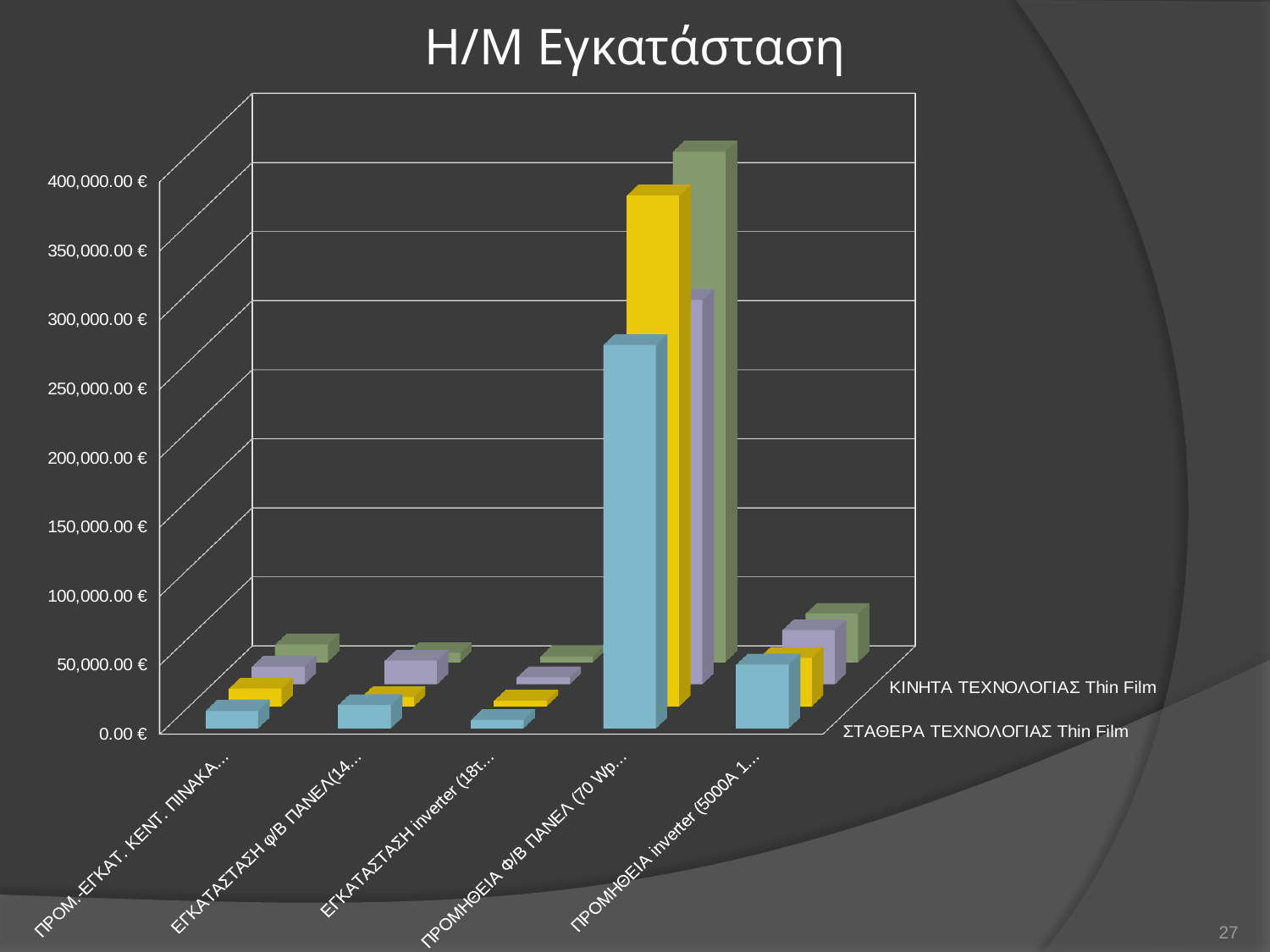
Is the value for ΠΡΟΜΗΘΕΙΑ inverter (5000A 1... in the ΣΤΑΘΕΡΑ ΤΕΧΝΟΛΟΓΙΑΣ Thin Film series greater or less than 100,000.00 €? less Is the value for ΠΡΟΜΗΘΕΙΑ Φ/Β ΠΑΝΕΛ (70 Wp... in the ΣΤΑΘΕΡΑ ΤΕΧΝΟΛΟΓΙΑΣ Thin Film series greater or less than 200,000.00 €? greater Which series label is shown at the front of the depth axis of the chart? ΣΤΑΘΕΡΑ ΤΕΧΝΟΛΟΓΙΑΣ Thin Film What is the highest value labelled on the vertical axis of the chart? 400,000.00 € How many bars (series) are plotted for each category in the chart? 4 What type of chart is shown on the slide? bar chart Is the value for ΠΡΟΜ.-ΕΓΚΑΤ. ΚΕΝΤ. ΠΙΝΑΚΑ... in the ΣΤΑΘΕΡΑ ΤΕΧΝΟΛΟΓΙΑΣ Thin Film series greater or less than 50,000.00 €? less What is the title of the chart? Η/Μ Εγκατάσταση In the ΣΤΑΘΕΡΑ ΤΕΧΝΟΛΟΓΙΑΣ Thin Film series, which is larger: ΠΡΟΜΗΘΕΙΑ Φ/Β ΠΑΝΕΛ (70 Wp... or ΠΡΟΜΗΘΕΙΑ inverter (5000A 1...? ΠΡΟΜΗΘΕΙΑ Φ/Β ΠΑΝΕΛ (70 Wp... How many categories are shown along the x axis of the chart? 5 Which category has the tallest bars in the chart? ΠΡΟΜΗΘΕΙΑ Φ/Β ΠΑΝΕΛ (70 Wp...